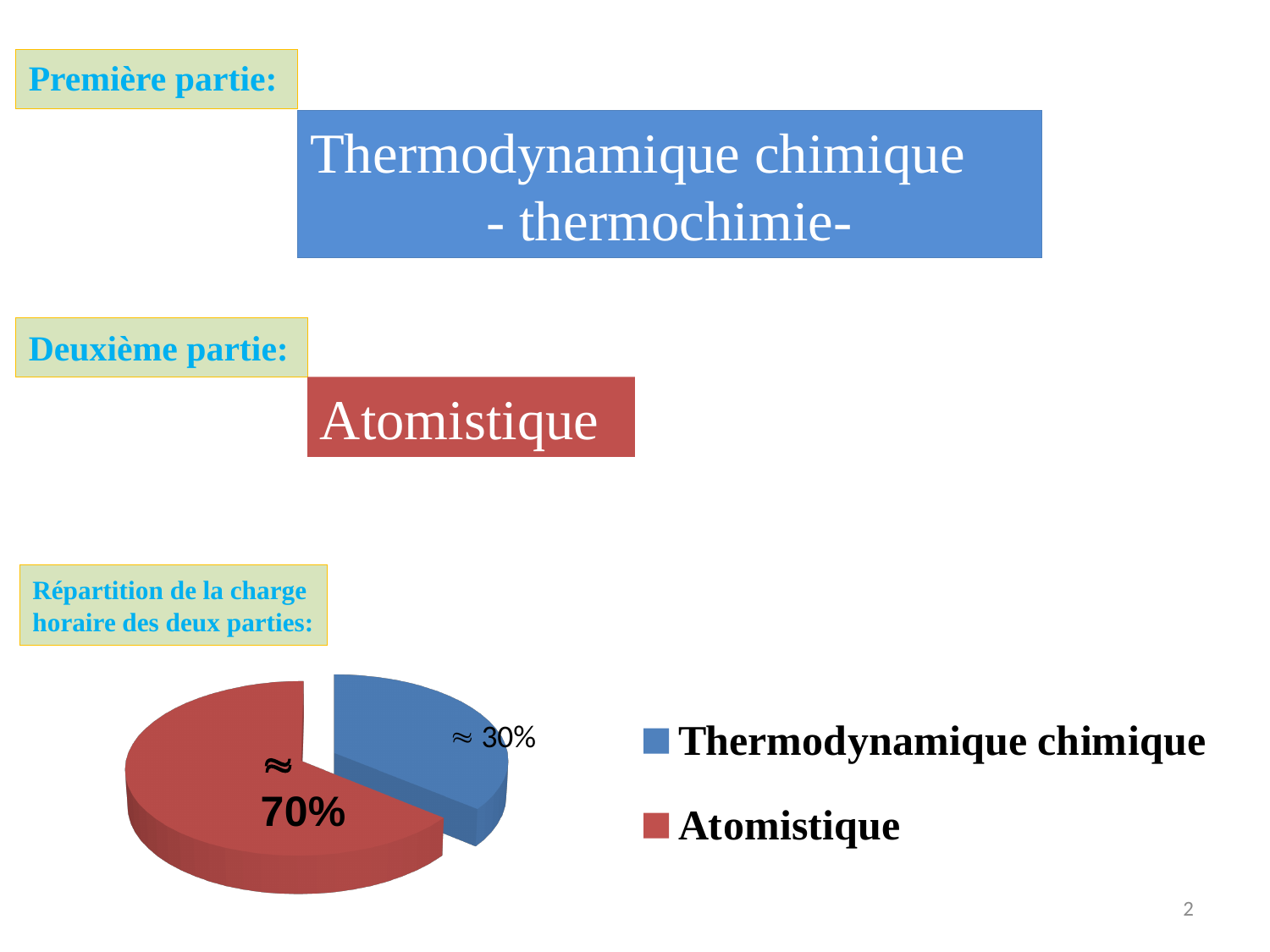
Which part has the smallest slice in the pie chart? Thermodynamique chimique Is the share for Thermodynamique chimique in the pie chart greater or less than 50%? less How many entries does the legend of the pie chart list? 2 How many slices does the pie chart have? 2 Which slice is larger in the pie chart, Thermodynamique chimique or Atomistique? Atomistique Which part has the largest slice in the pie chart? Atomistique Is the share for Atomistique in the pie chart greater or less than 50%? greater What colour is the Thermodynamique chimique slice in the pie chart? blue What kind of chart is shown on the slide? pie chart What colour is the Atomistique slice in the pie chart? red